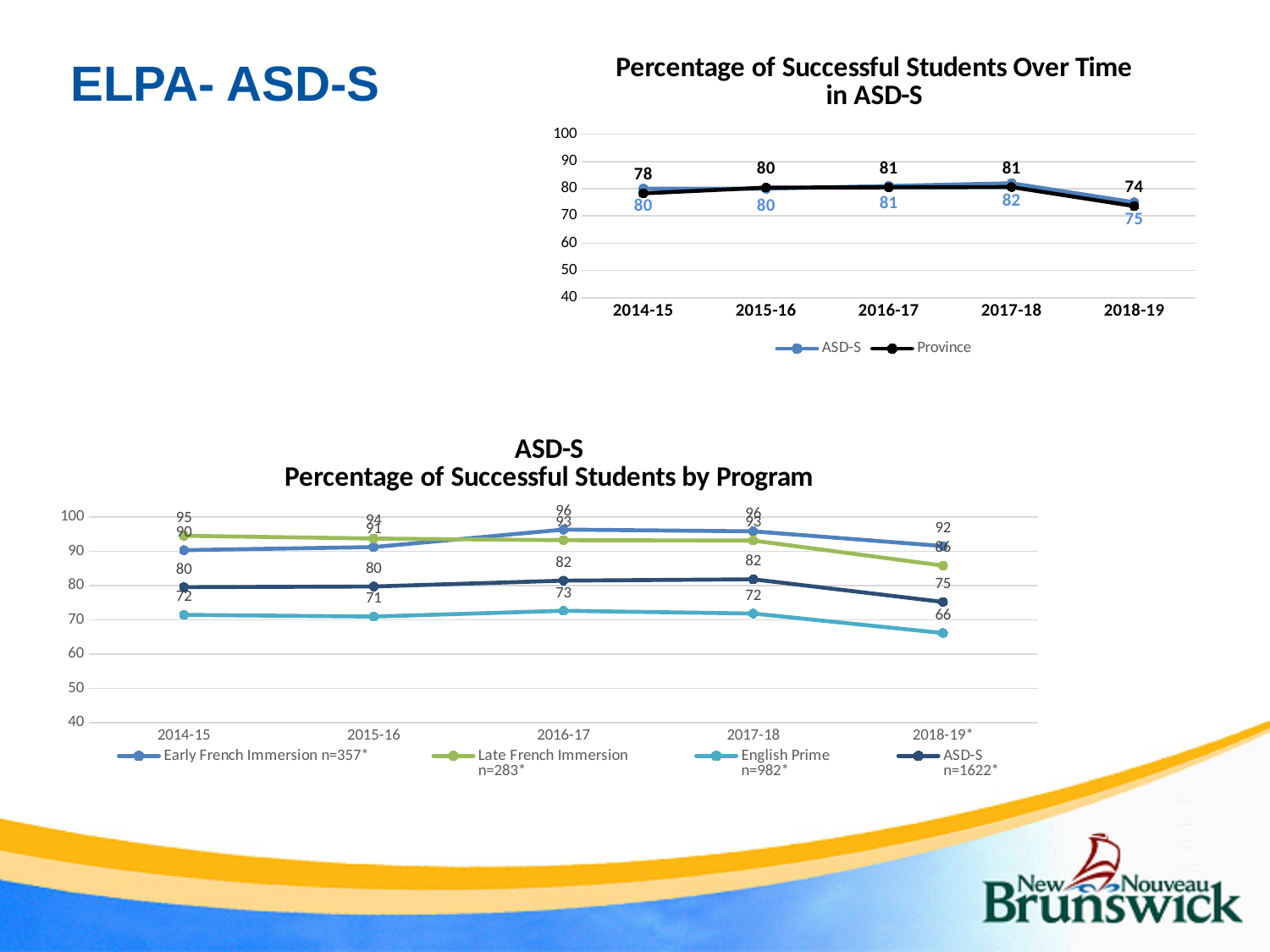
In the bottom chart, 'ASD-S Percentage of Successful Students by Program', which program has the lowest value in 2017-18? English Prime In the bottom chart, 'ASD-S Percentage of Successful Students by Program', what is the Early French Immersion value for 2016-17? 96 In the top chart, 'Percentage of Successful Students Over Time in ASD-S', what is the Province value for 2014-15? 78 In the bottom chart, 'ASD-S Percentage of Successful Students by Program', how many series does the legend list? 4 In the top chart, 'Percentage of Successful Students Over Time in ASD-S', what is the difference between the ASD-S value in 2017-18 and in 2018-19? 7 In the top chart, 'Percentage of Successful Students Over Time in ASD-S', how many series does the legend list? 2 In the top chart, 'Percentage of Successful Students Over Time in ASD-S', what kind of chart is shown? Line chart In the top chart, 'Percentage of Successful Students Over Time in ASD-S', what is the ASD-S value for 2017-18? 82 In the bottom chart, 'ASD-S Percentage of Successful Students by Program', which is larger in 2014-15: Early French Immersion or Late French Immersion? Late French Immersion In the bottom chart, 'ASD-S Percentage of Successful Students by Program', what is the English Prime value for 2018-19*? 66 In the bottom chart, 'ASD-S Percentage of Successful Students by Program', how many years are shown on the x axis? 5 In the top chart, 'Percentage of Successful Students Over Time in ASD-S', in which year is the Province value lowest? 2018-19